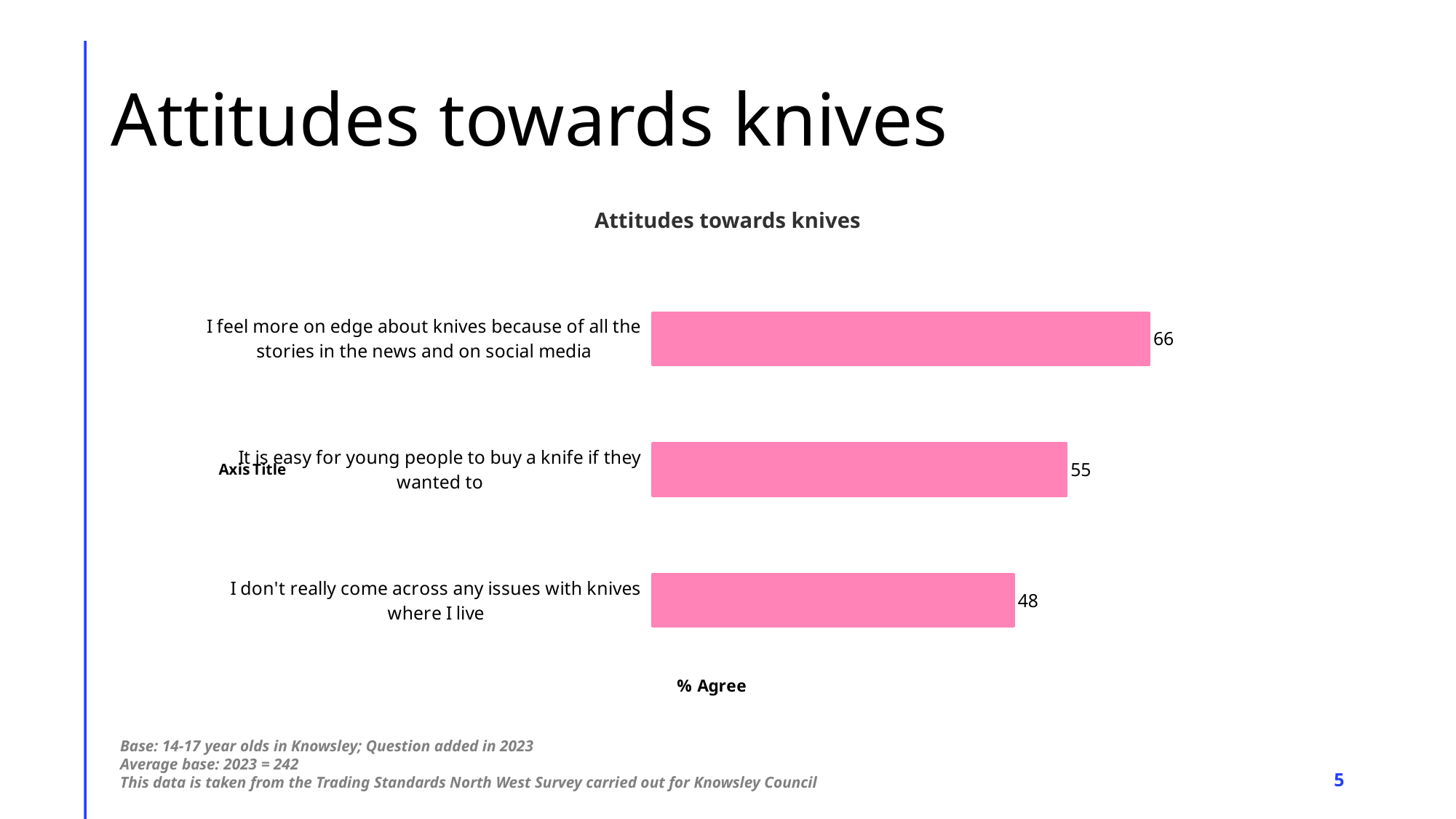
What is the label on the horizontal axis of the chart? % Agree What kind of chart is shown on the slide? Bar chart What is the value for "I feel more on edge about knives because of all the stories in the news and on social media"? 66 Which statement has the lowest % Agree? I don't really come across any issues with knives where I live Which has a larger value: "It is easy for young people to buy a knife if they wanted to" or "I don't really come across any issues with knives where I live"? It is easy for young people to buy a knife if they wanted to What is the difference between the values for "It is easy for young people to buy a knife if they wanted to" and "I don't really come across any issues with knives where I live"? 7 What is the title of the chart? Attitudes towards knives What is the value for "It is easy for young people to buy a knife if they wanted to"? 55 What is the value for "I don't really come across any issues with knives where I live"? 48 Which statement has the highest % Agree? I feel more on edge about knives because of all the stories in the news and on social media How many statements are shown in the chart? 3 What is the difference between the values for "I feel more on edge about knives because of all the stories in the news and on social media" and "I don't really come across any issues with knives where I live"? 18